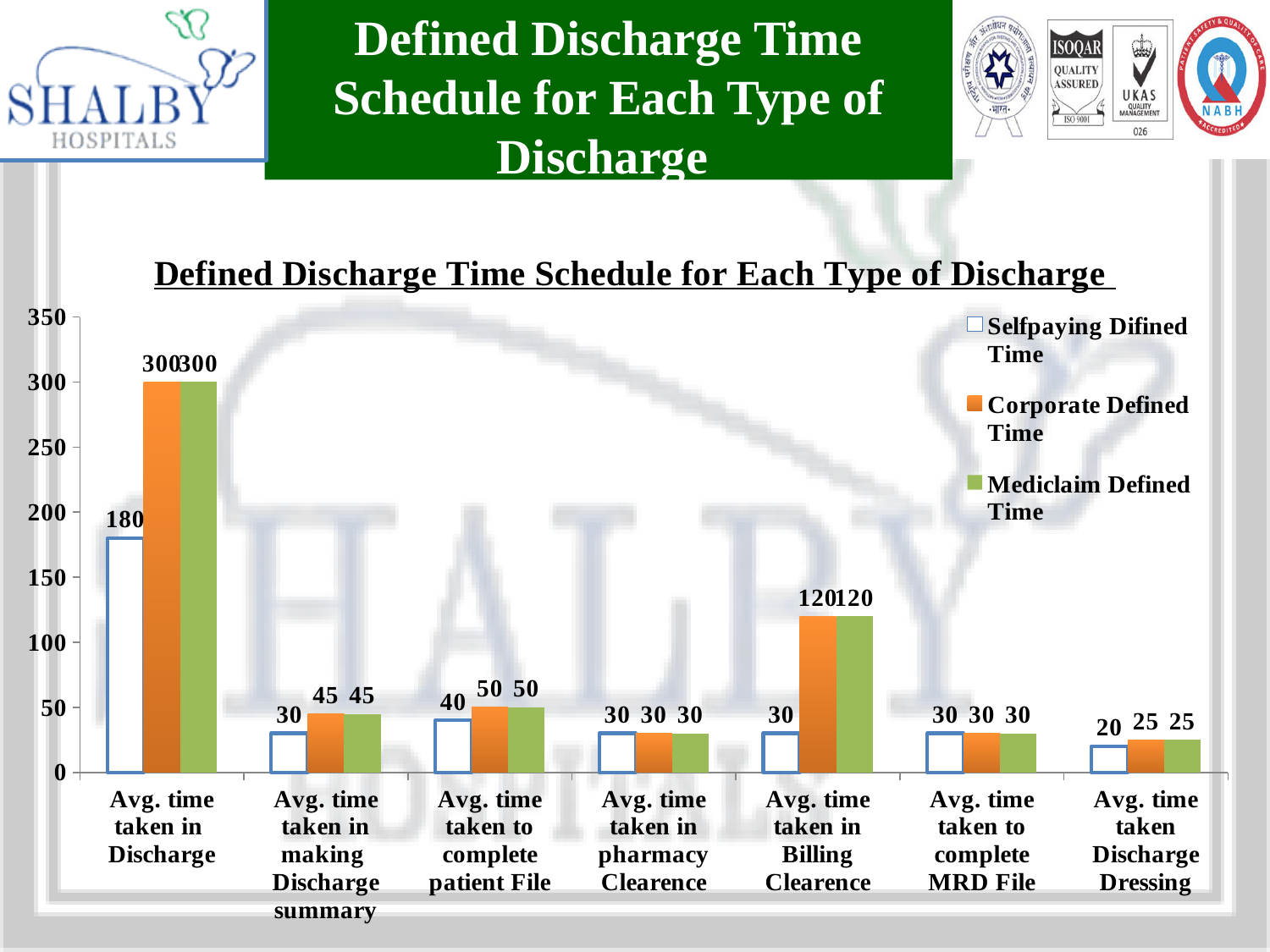
What is the title of the chart? Defined Discharge Time Schedule for Each Type of Discharge What is the Mediclaim Defined Time for Avg. time taken Discharge Dressing? 25 Which is larger for Avg. time taken in Billing Clearence: the Selfpaying Difined Time or the Mediclaim Defined Time? Mediclaim Defined Time How many series does the chart legend list? 3 What is the Corporate Defined Time for Avg. time taken in Billing Clearence? 120 What type of chart is shown on the slide? Bar chart What is the difference between the Corporate Defined Time and the Selfpaying Difined Time for Avg. time taken in making Discharge summary? 15 What is the Selfpaying Difined Time for Avg. time taken in Discharge? 180 Which category has the highest Corporate Defined Time? Avg. time taken in Discharge How many categories are shown on the x axis of the chart? 7 Which category has the lowest Selfpaying Difined Time? Avg. time taken Discharge Dressing What is the difference between the Corporate Defined Time and the Selfpaying Difined Time for Avg. time taken in Discharge? 120